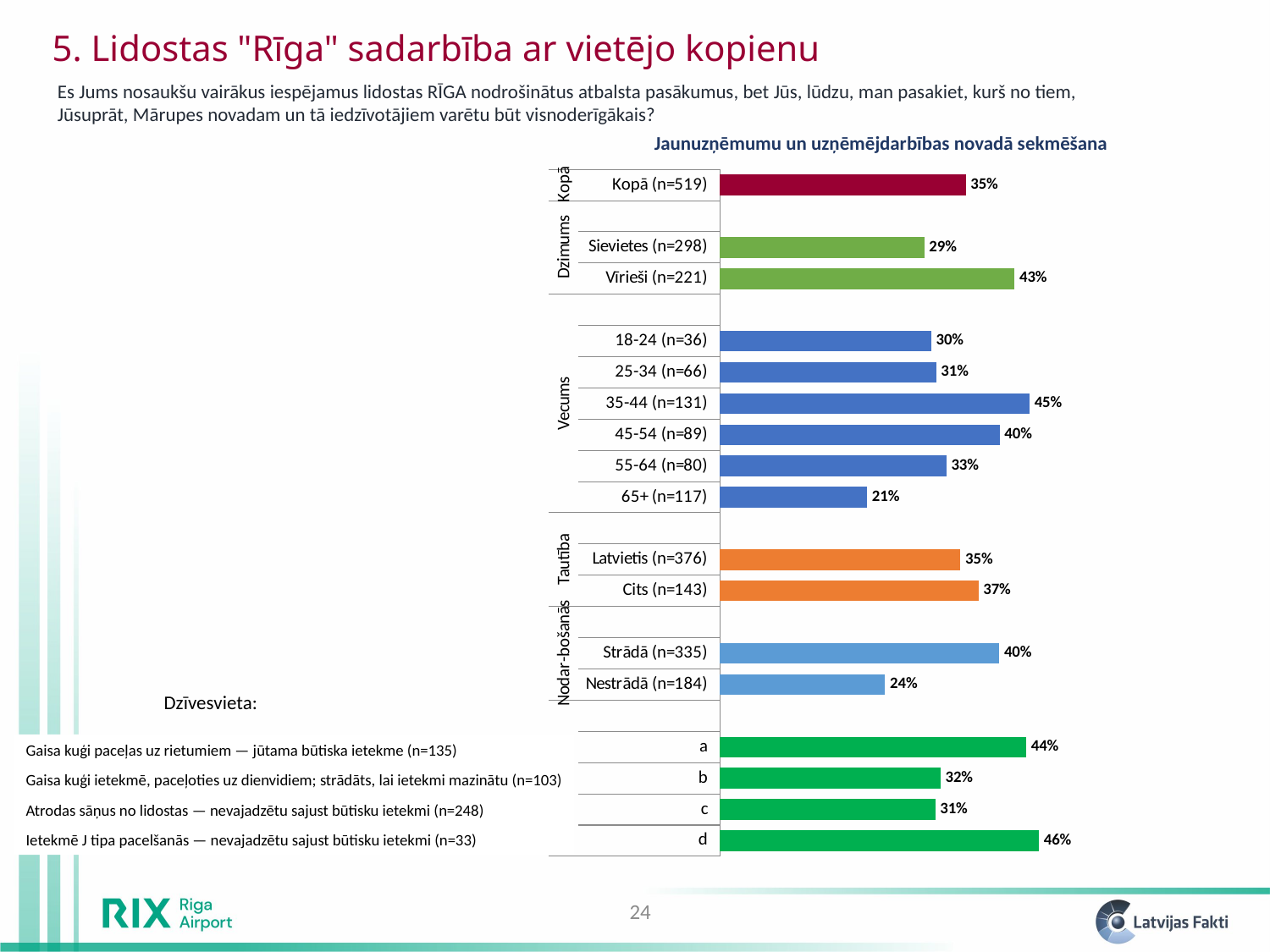
What is the difference between the values for Strādā (n=335) and Nestrādā (n=184)? 16% What is the value for Vīrieši (n=221)? 43% What is the value for Kopā (n=519)? 35% Which age group (Vecums) has the lowest value? 65+ (n=117) Which is larger, the value for Cits (n=143) or Latvietis (n=376)? Cits (n=143) What is the value for 65+ (n=117)? 21% What is the difference between the values for Vīrieši (n=221) and Sievietes (n=298)? 14% How many bars are plotted in the chart? 17 What type of chart is shown on the slide? Bar chart Which category has the highest value in the chart? d What is the value for Nestrādā (n=184)? 24% What is the title of the chart? Jaunuzņēmumu un uzņēmējdarbības novadā sekmēšana